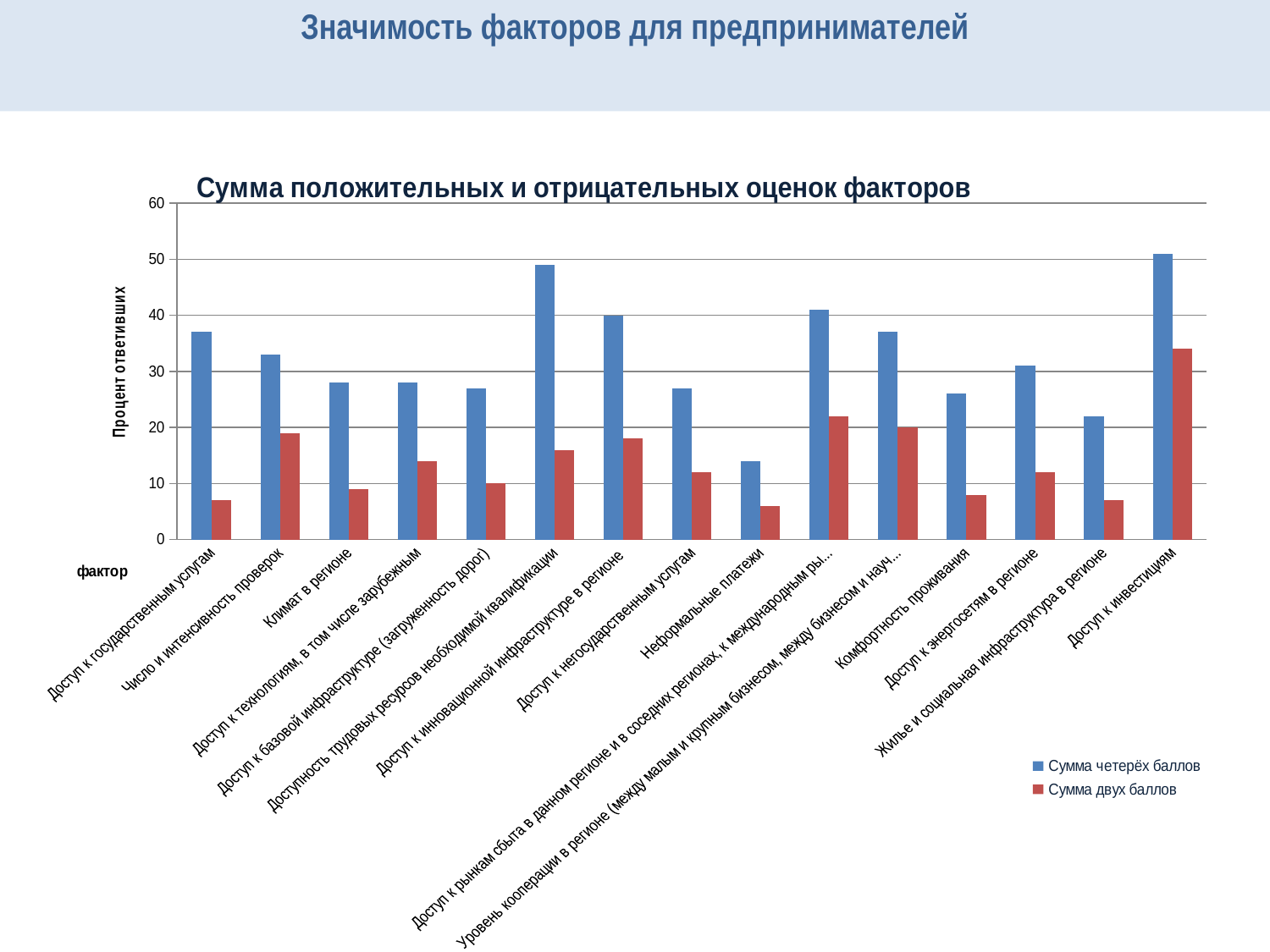
Which factor has the highest value for the series 'Сумма двух баллов'? Доступ к инвестициям What kind of chart is shown on the slide? bar chart How many factor categories are plotted along the x axis? 15 Is the 'Сумма четерёх баллов' value for 'Доступ к государственным услугам' greater or less than 30? greater How many series does the legend list? 2 Which factor has the lowest value for the series 'Сумма четерёх баллов'? Неформальные платежи Is the 'Сумма двух баллов' value for 'Доступ к инвестициям' greater or less than 30? greater For the series 'Сумма четерёх баллов', which is larger: 'Доступ к инновационной инфраструктуре в регионе' or 'Доступ к негосударственным услугам'? Доступ к инновационной инфраструктуре в регионе Is the 'Сумма четерёх баллов' value for 'Комфортность проживания' greater or less than 30? less For 'Доступ к инвестициям', which series has the larger value: 'Сумма четерёх баллов' or 'Сумма двух баллов'? Сумма четерёх баллов What is the title of the chart? Сумма положительных и отрицательных оценок факторов